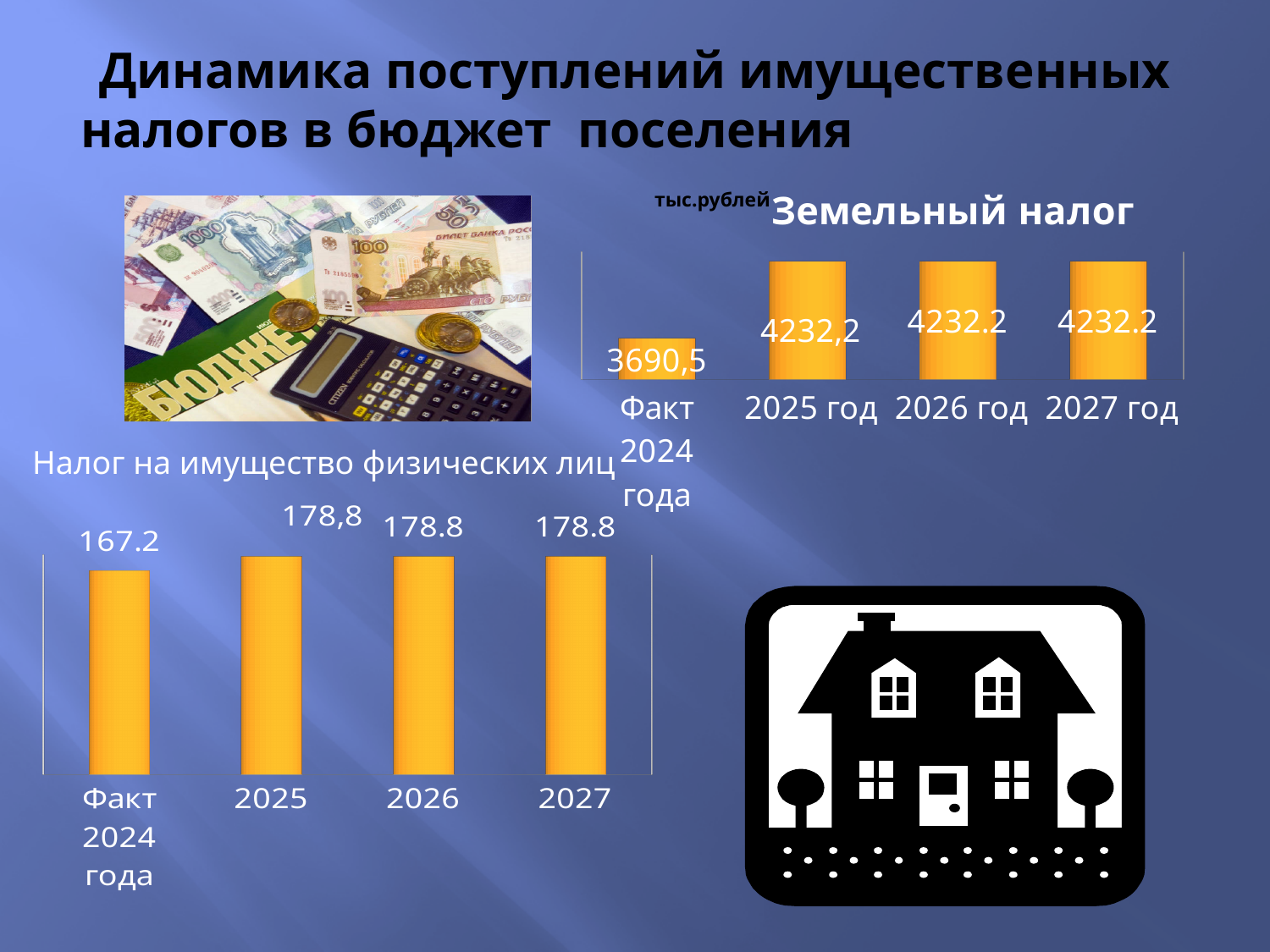
In the 'Земельный налог' chart, what is the value for '2026 год'? 4232.2 In the 'Земельный налог' chart, what unit is indicated next to the chart title? тыс.рублей In the 'Налог на имущество физических лиц' chart, what is the value for 2027? 178.8 In the 'Налог на имущество физических лиц' chart, what is the difference between the value for 2026 and the value for 'Факт 2024 года'? 11.6 In the 'Земельный налог' chart, how many bars are plotted? 4 In the 'Налог на имущество физических лиц' chart, which category has the lowest value? Факт 2024 года In the 'Земельный налог' chart, which category has the lowest value? Факт 2024 года In the 'Земельный налог' chart, what is the difference between the value for '2025 год' and the value for 'Факт 2024 года'? 541,7 In the 'Земельный налог' chart, what is the value for 'Факт 2024 года'? 3690,5 What type of chart is the 'Налог на имущество физических лиц' chart? Bar chart In the 'Налог на имущество физических лиц' chart, which is larger: the value for 2025 or the value for 'Факт 2024 года'? 2025 In the 'Налог на имущество физических лиц' chart, what is the value for 'Факт 2024 года'? 167.2